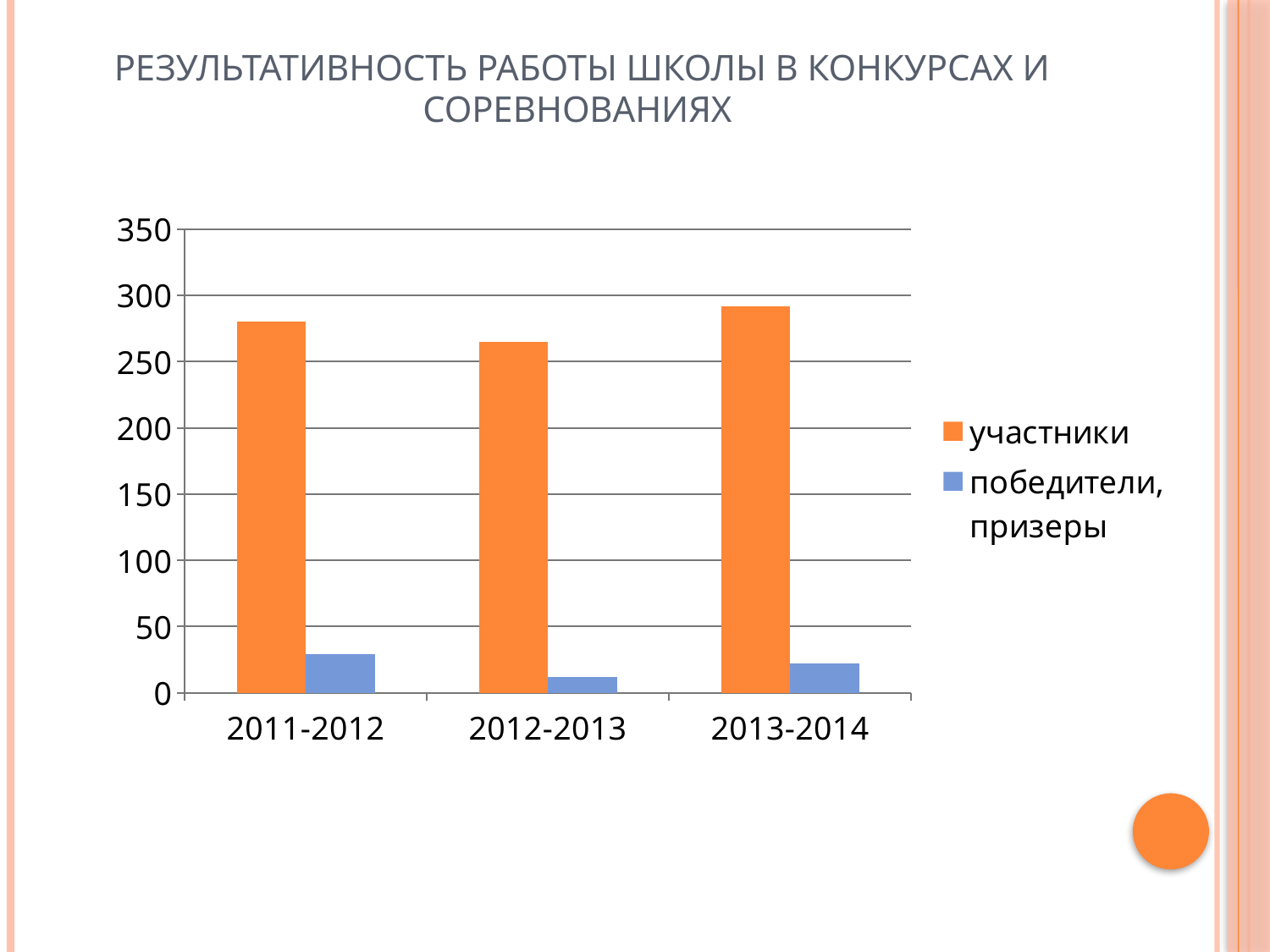
Which school year has the highest value for участники? 2013-2014 How many series does the legend list? 2 Is the value for участники in 2013-2014 greater or less than 300? less Which school year has the highest value for победители, призеры? 2011-2012 How many school-year categories are shown on the x axis? 3 Is the value for участники in 2011-2012 greater or less than 250? greater Is the value for победители, призеры in 2011-2012 greater or less than 50? less Which is larger: участники in 2012-2013 or участники in 2013-2014? участники in 2013-2014 Which school year has the lowest value for участники? 2012-2013 What colour are the bars for the участники series? orange What kind of chart is shown on the slide? bar chart Which school year has the lowest value for победители, призеры? 2012-2013